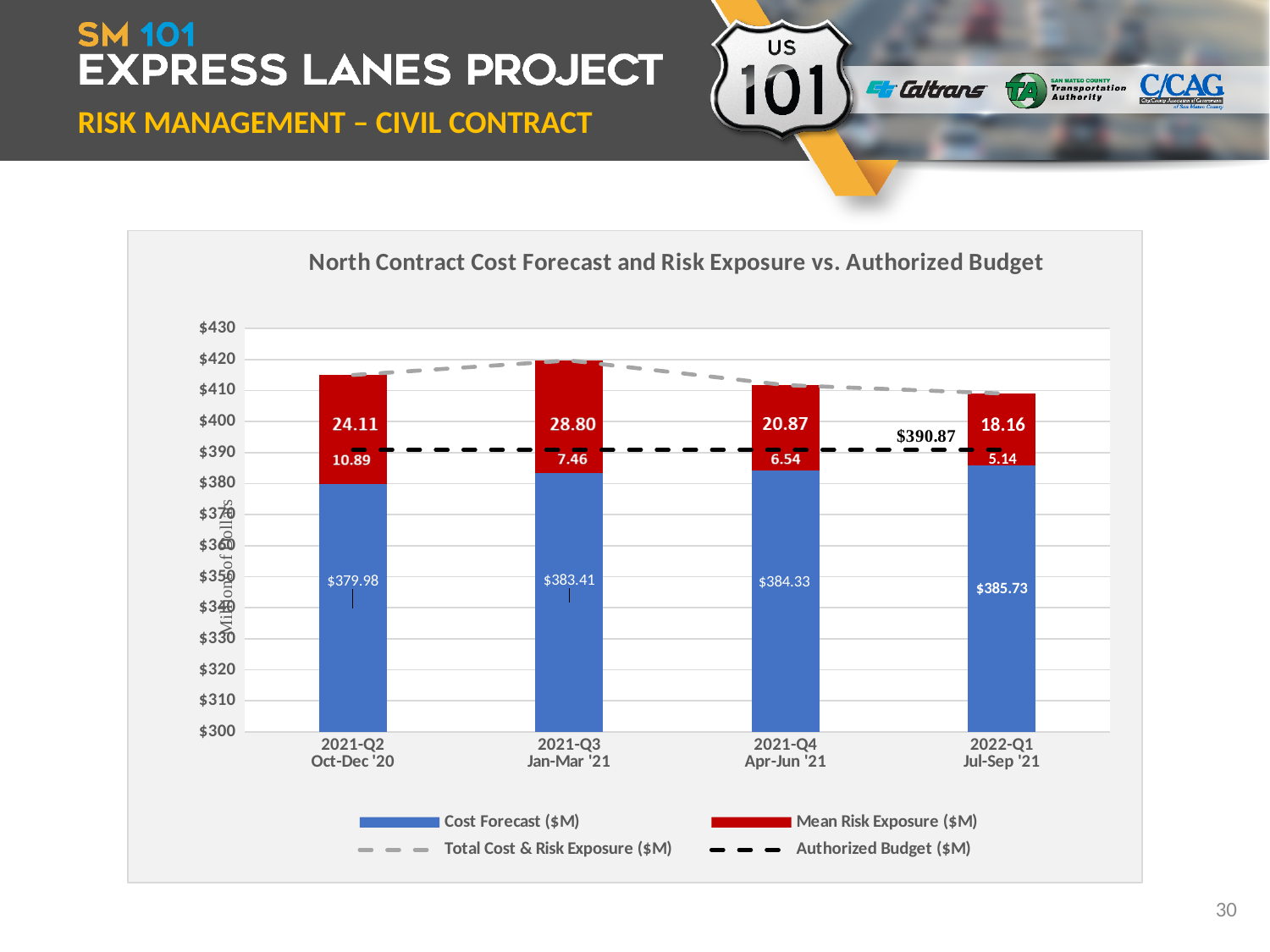
How many quarters are shown on the x axis? 4 What is the Authorized Budget ($M) shown on the chart? $390.87 Which has the larger Cost Forecast, 2021-Q4 Apr-Jun '21 or 2022-Q1 Jul-Sep '21? 2022-Q1 Jul-Sep '21 Does the Cost Forecast rise or fall from 2021-Q2 to 2022-Q1? rises Which quarter has the highest Mean Risk Exposure? 2021-Q3 Jan-Mar '21 What is the Cost Forecast ($M) for 2021-Q3 Jan-Mar '21? $383.41 By how much does the Cost Forecast for 2022-Q1 exceed the Cost Forecast for 2021-Q2? $5.75 How many series does the legend list? 4 Which quarter has the lowest Cost Forecast? 2021-Q2 Oct-Dec '20 Is the Total Cost & Risk Exposure for 2021-Q3 greater or less than $410? greater